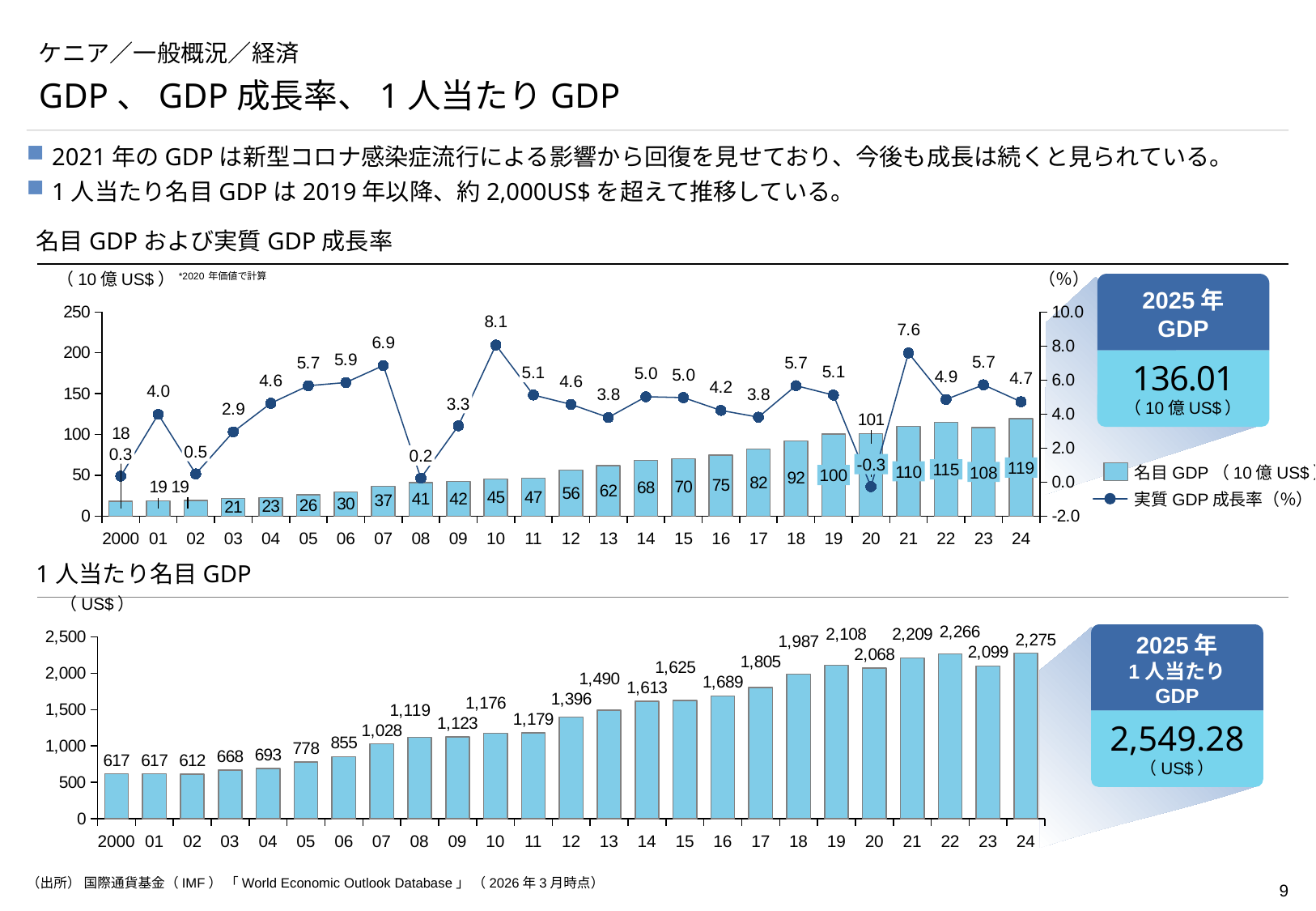
In the top chart (名目GDPおよび実質GDP成長率), which year has the lowest real GDP growth rate? 2020 In the top chart (名目GDPおよび実質GDP成長率), how many series does the legend list? 2 In the bottom chart (1人当たり名目GDP), what is the difference between the values for 2019 and 2020? 40 In the top chart (名目GDPおよび実質GDP成長率), what is the difference between the nominal GDP of 2024 and 2023? 11 In the top chart (名目GDPおよび実質GDP成長率), what is the nominal GDP value for 2024? 119 In the bottom chart (1人当たり名目GDP), how many years are plotted? 25 In the bottom chart (1人当たり名目GDP), what is the value for 2024? 2,275 In the top chart (名目GDPおよび実質GDP成長率), what is the real GDP growth rate for 2010? 8.1 In the bottom chart (1人当たり名目GDP), which is larger, the value for 2022 or the value for 2023? 2022 What kind of chart is the bottom chart (1人当たり名目GDP)? Bar chart In the bottom chart (1人当たり名目GDP), which year has the lowest value? 2002 In the top chart (名目GDPおよび実質GDP成長率), which year has the highest real GDP growth rate? 2010